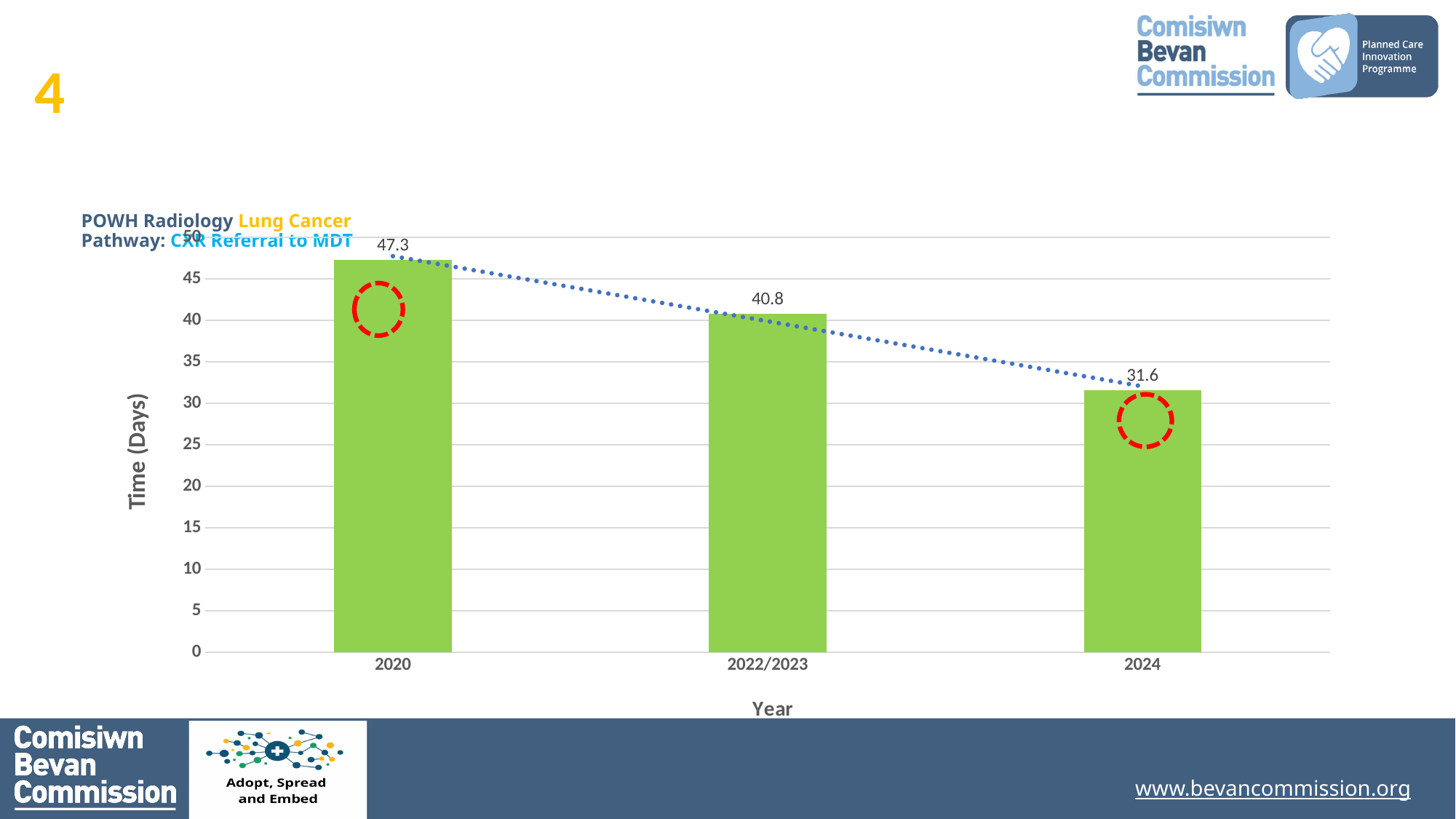
What is the difference between the values for 2020 and 2024? 15.7 What kind of chart is this? bar chart What is the value for 2022/2023? 40.8 Which year has the lowest value? 2024 Which is larger, the value for 2022/2023 or the value for 2024? 2022/2023 What is the value for 2020? 47.3 How many years are shown on the x axis? 3 What is the difference between the values for 2020 and 2022/2023? 6.5 Is the value for 2024 greater or less than 35? less Do the values rise or fall from 2020 to 2024? fall Which year has the highest value? 2020 What is the value for 2024? 31.6